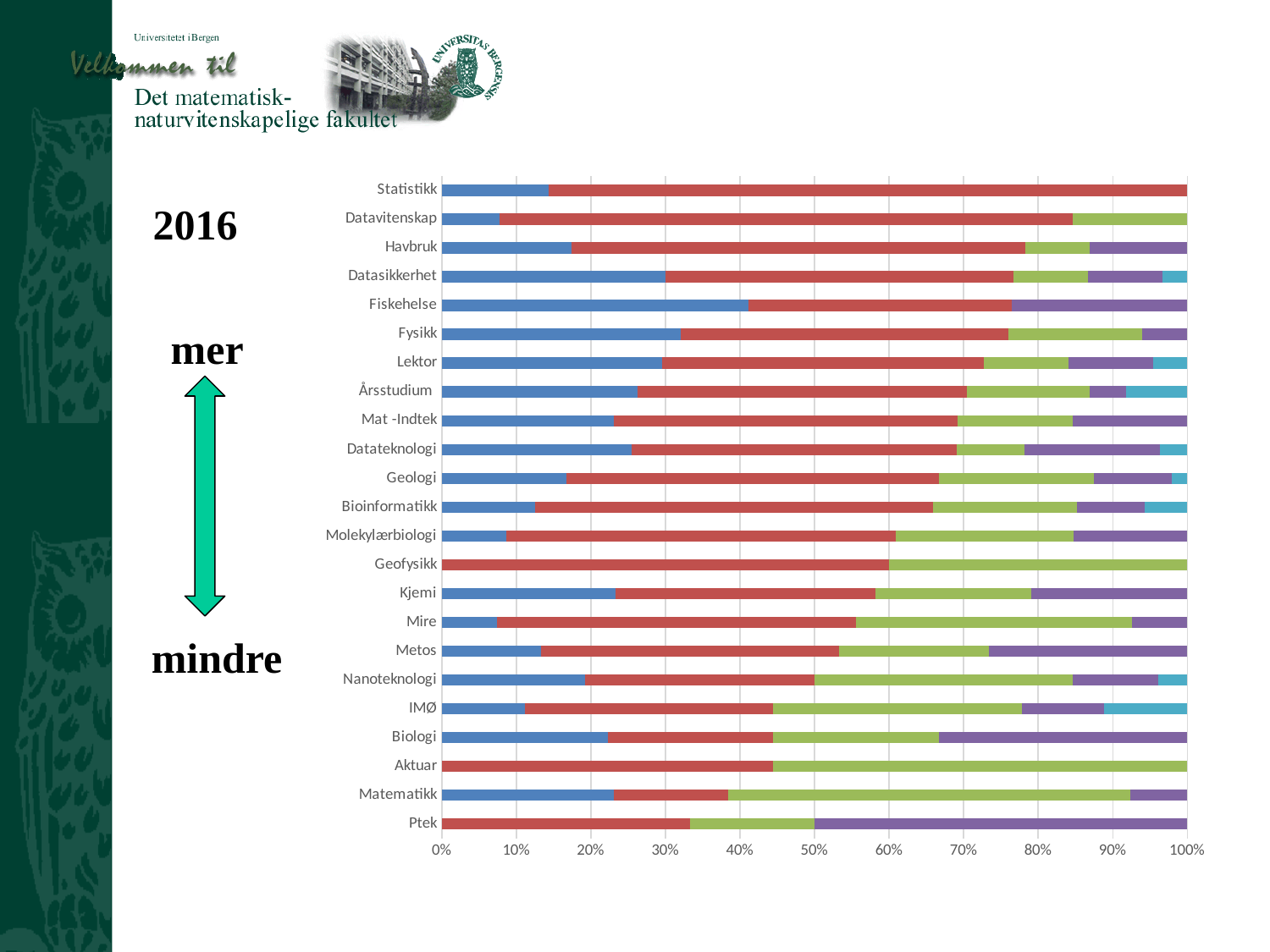
Is the blue segment for Fysikk greater or less than 20%? greater What year is shown as the label next to the chart? 2016 Which has the longer blue segment, Statistikk or Fiskehelse? Fiskehelse How many categories (programmes) are listed on the vertical axis of the chart? 23 Which has the longer blue segment, Havbruk or Datasikkerhet? Datasikkerhet Is the blue segment for Molekylærbiologi greater or less than 10%? less Is the blue segment for Statistikk greater or less than 20%? less What kind of chart is shown on the slide? Stacked bar chart What does each full stacked bar in the chart add up to? 100% Which category has the longest blue segment in the chart? Fiskehelse What is the highest value shown on the horizontal axis of the chart? 100%